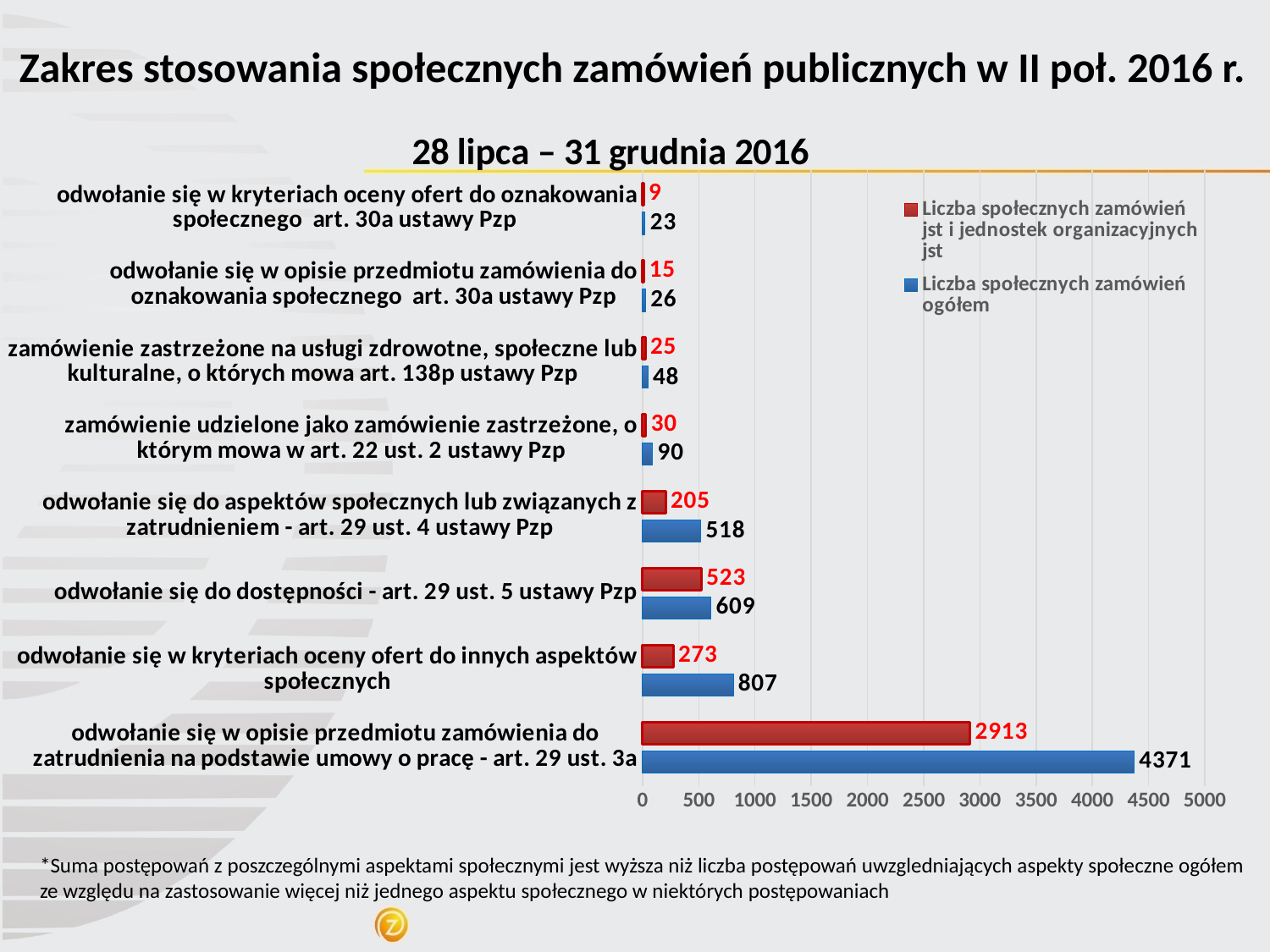
How many categories are shown in the chart? 8 What is the value of "Liczba społecznych zamówień ogółem" for "odwołanie się w opisie przedmiotu zamówienia do zatrudnienia na podstawie umowy o pracę - art. 29 ust. 3a"? 4371 What is the difference between "Liczba społecznych zamówień ogółem" and "Liczba społecznych zamówień jst i jednostek organizacyjnych jst" for "odwołanie się do aspektów społecznych lub związanych z zatrudnieniem - art. 29 ust. 4 ustawy Pzp"? 313 Which category has the highest value of "Liczba społecznych zamówień ogółem"? odwołanie się w opisie przedmiotu zamówienia do zatrudnienia na podstawie umowy o pracę - art. 29 ust. 3a Which category has the lowest value of "Liczba społecznych zamówień jst i jednostek organizacyjnych jst"? odwołanie się w kryteriach oceny ofert do oznakowania społecznego art. 30a ustawy Pzp Which is larger for "zamówienie udzielone jako zamówienie zastrzeżone, o którym mowa w art. 22 ust. 2 ustawy Pzp": "Liczba społecznych zamówień ogółem" or "Liczba społecznych zamówień jst i jednostek organizacyjnych jst"? Liczba społecznych zamówień ogółem Is the value of "Liczba społecznych zamówień jst i jednostek organizacyjnych jst" for "odwołanie się w opisie przedmiotu zamówienia do zatrudnienia na podstawie umowy o pracę - art. 29 ust. 3a" greater or less than 2500? greater What kind of chart is shown on the slide? bar chart What is the value of "Liczba społecznych zamówień ogółem" for "odwołanie się w kryteriach oceny ofert do innych aspektów społecznych"? 807 What is the title of the chart? 28 lipca – 31 grudnia 2016 What is the value of "Liczba społecznych zamówień jst i jednostek organizacyjnych jst" for "odwołanie się do dostępności - art. 29 ust. 5 ustawy Pzp"? 523 How many series does the legend list? 2